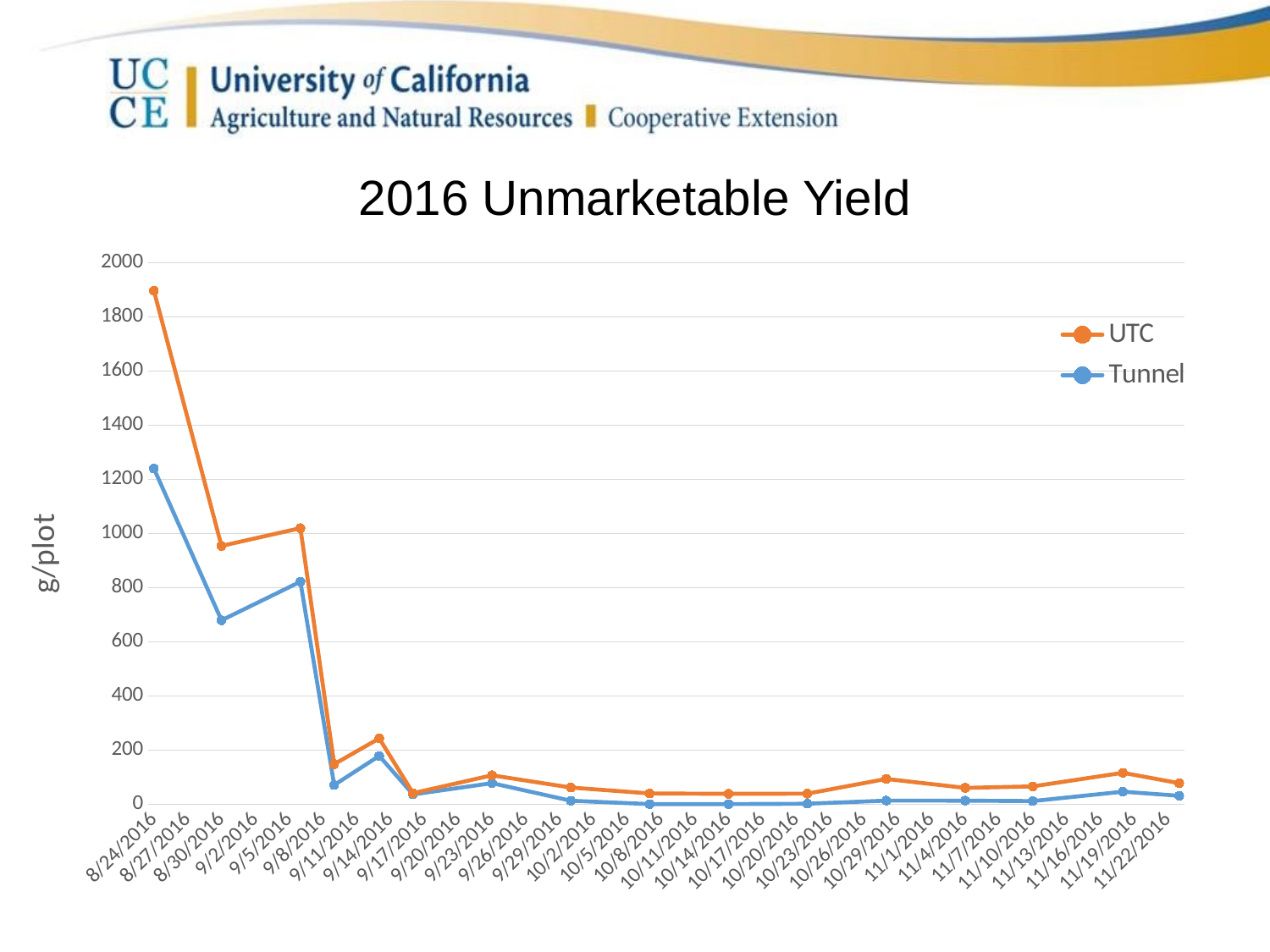
On which date does the UTC series reach its highest value? 8/24/2016 Is the Tunnel value on 8/24/2016 greater or less than 1000? greater Do the values generally rise or fall from 8/24/2016 to 11/22/2016? fall Is the UTC value on 8/30/2016 greater or less than 800? greater What kind of chart is shown on the slide? line chart Is the UTC value on 8/24/2016 greater or less than 1800? greater What is the label on the vertical axis? g/plot What is the title of the chart? 2016 Unmarketable Yield On which date does the Tunnel series reach its highest value? 8/24/2016 On 8/24/2016, which series has the larger value, UTC or Tunnel? UTC How many series does the legend list? 2